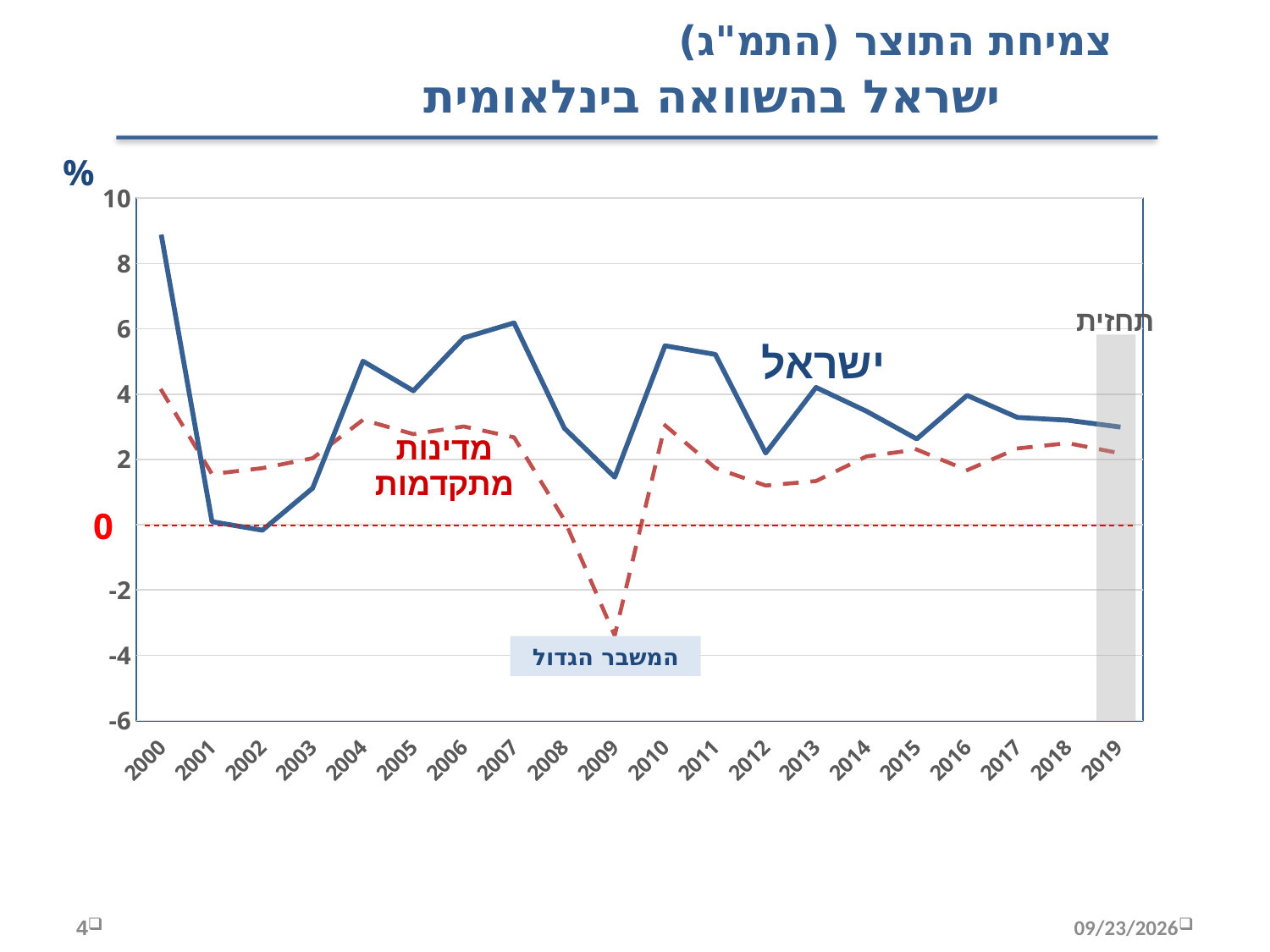
Is the value for ישראל in 2012 greater or less than 4? less In 2009, which series has the larger value, ישראל or מדינות מתקדמות? ישראל What text appears in the annotation box near the 2009 dip in the chart? המשבר הגדול Does the ישראל series rise or fall from 2000 to 2002? fall How many series are plotted in the chart? 2 In which year does the ישראל series reach its highest value? 2000 In which year does the מדינות מתקדמות series reach its lowest value? 2009 Which year is marked with a shaded bar labelled תחזית? 2019 Is the value for ישראל in 2000 greater or less than 8? greater What kind of chart is shown on the slide? line chart How many years are shown along the x axis of the chart? 20 Is the value for מדינות מתקדמות in 2009 greater or less than -2? less